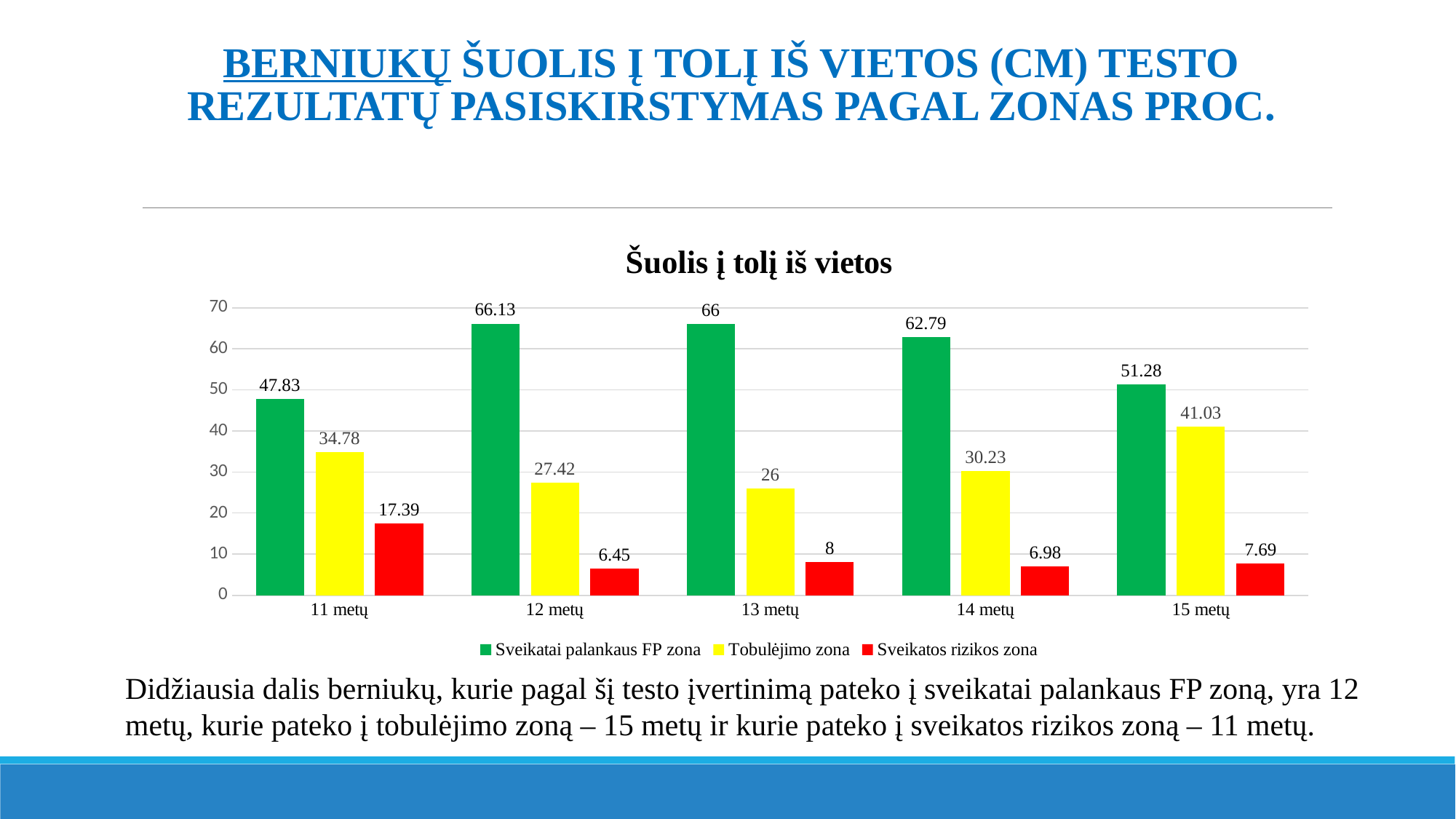
Which is larger at 15 metų: Tobulėjimo zona or Sveikatos rizikos zona? Tobulėjimo zona What is the value for Sveikatos rizikos zona at 13 metų? 8 What is the difference between Sveikatai palankaus FP zona and Sveikatos rizikos zona at 11 metų? 30.44 How many age groups are shown on the x axis? 5 How many series does the legend list? 3 What is the value for Tobulėjimo zona at 14 metų? 30.23 Which age group has the lowest value for Sveikatai palankaus FP zona? 11 metų What is the value for Sveikatai palankaus FP zona at 12 metų? 66.13 Is the value for Sveikatai palankaus FP zona at 14 metų greater or less than 60? greater What is the title of the chart? Šuolis į tolį iš vietos What type of chart is shown on the slide? bar chart Which age group has the highest value for Sveikatos rizikos zona? 11 metų